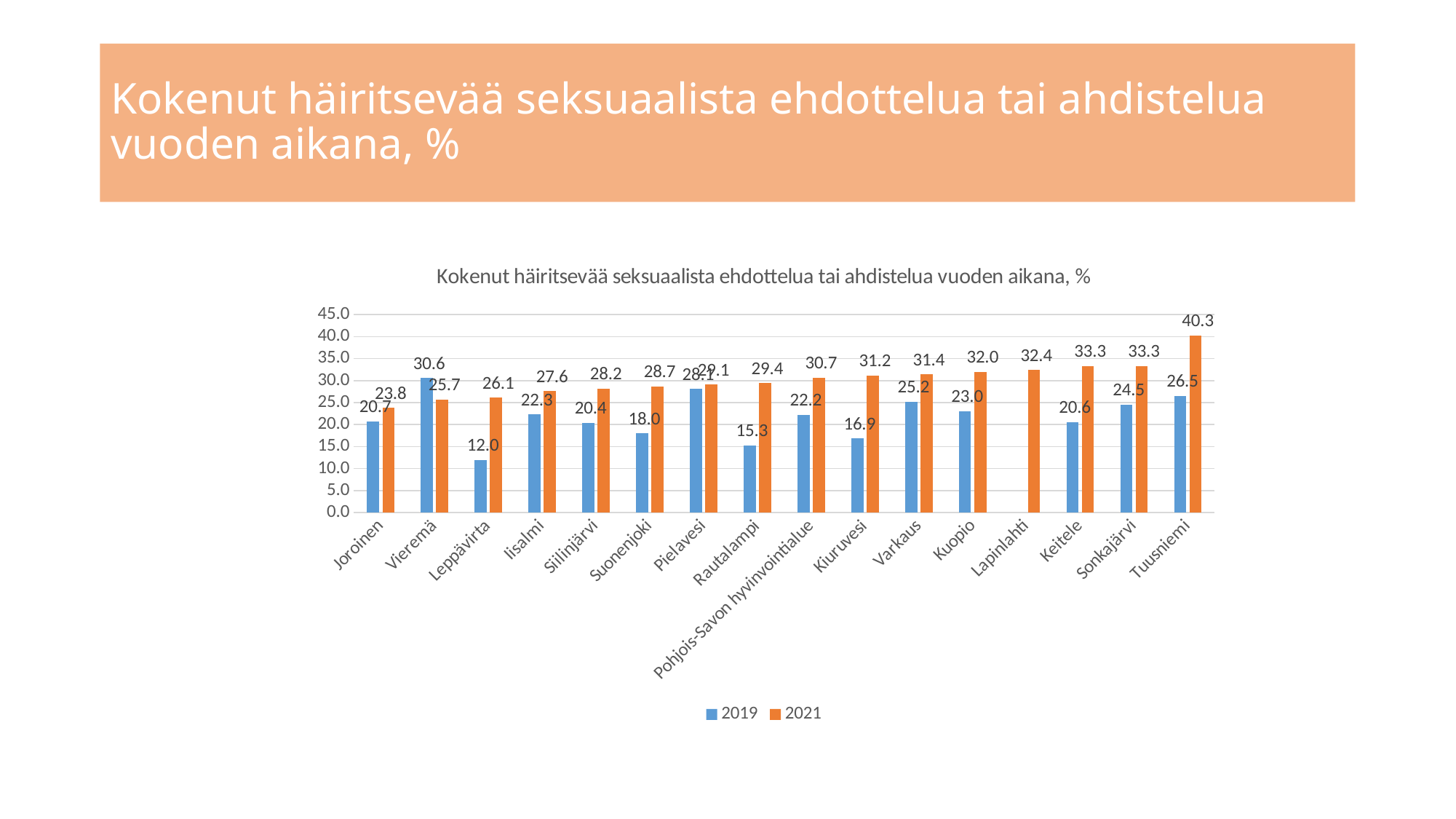
Do the 2021 values rise or fall from left to right along the x axis? Rise What is the 2021 value for Pohjois-Savon hyvinvointialue? 30.7 How many categories are shown on the x axis? 16 What kind of chart is shown on the slide? Bar chart For Vieremä, which is larger: the 2019 value or the 2021 value? 2019 How many series does the legend list? 2 Which category has the highest 2021 value? Tuusniemi What is the 2021 value for Tuusniemi? 40.3 What is the 2019 value for Leppävirta? 12.0 Which category has no 2019 bar? Lapinlahti Which category has the lowest 2019 value? Leppävirta What is the difference between the 2021 and 2019 values for Tuusniemi? 13.8